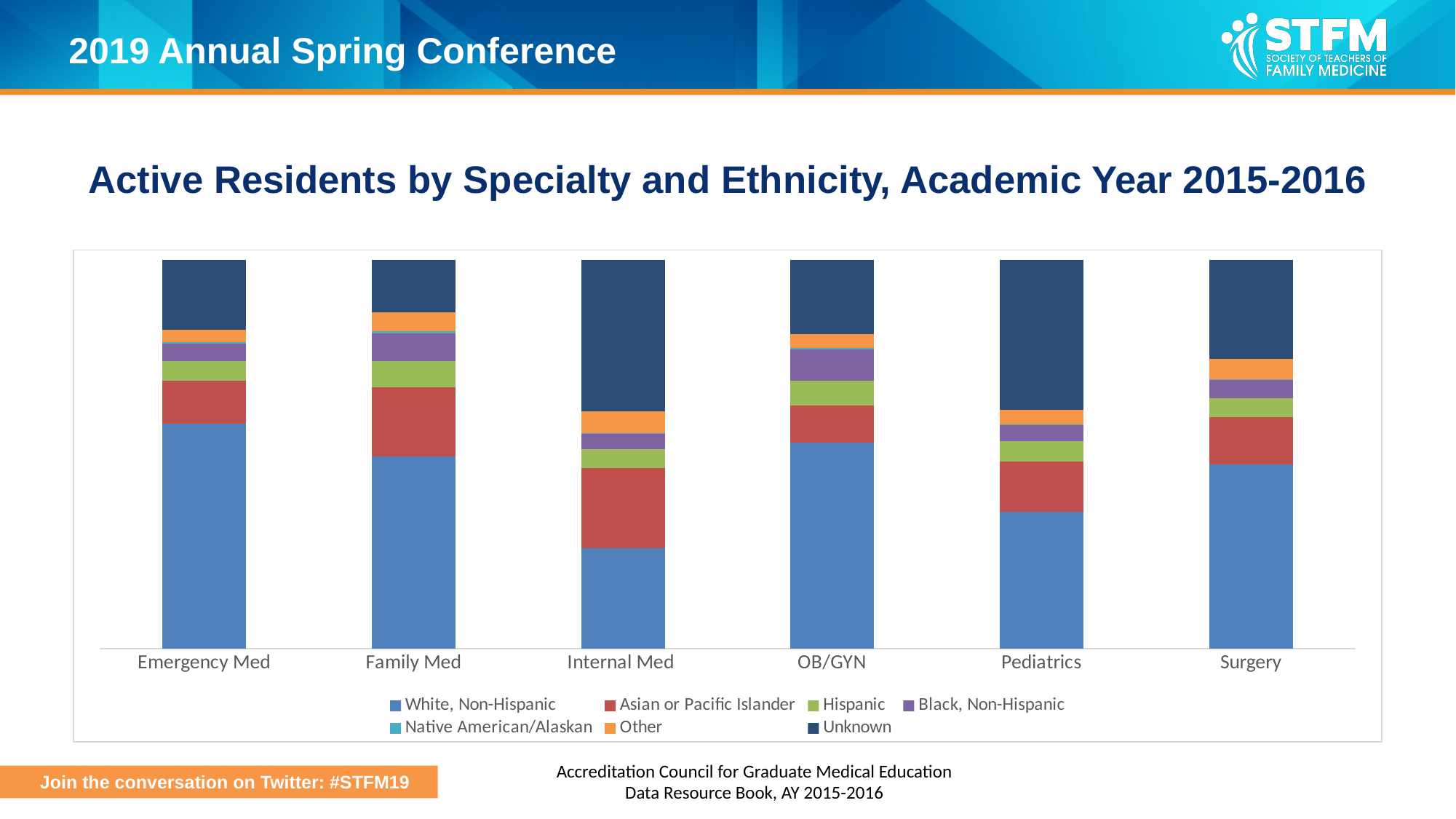
Is the Asian or Pacific Islander segment larger for Internal Med or for Emergency Med? Internal Med What kind of chart is shown on the slide? Stacked bar chart Which specialty has the largest Asian or Pacific Islander segment? Internal Med Which legend entry is shown in dark navy blue at the top of each bar? Unknown Which specialty has the largest White, Non-Hispanic segment? Emergency Med Is the Unknown segment larger for Pediatrics or for Family Med? Pediatrics Which specialty has the smallest Unknown segment? Family Med Which specialty has the smallest White, Non-Hispanic segment? Internal Med What is the title of the chart? Active Residents by Specialty and Ethnicity, Academic Year 2015-2016 How many specialties are shown along the x axis of the chart? 6 How many series does the chart's legend list? 7